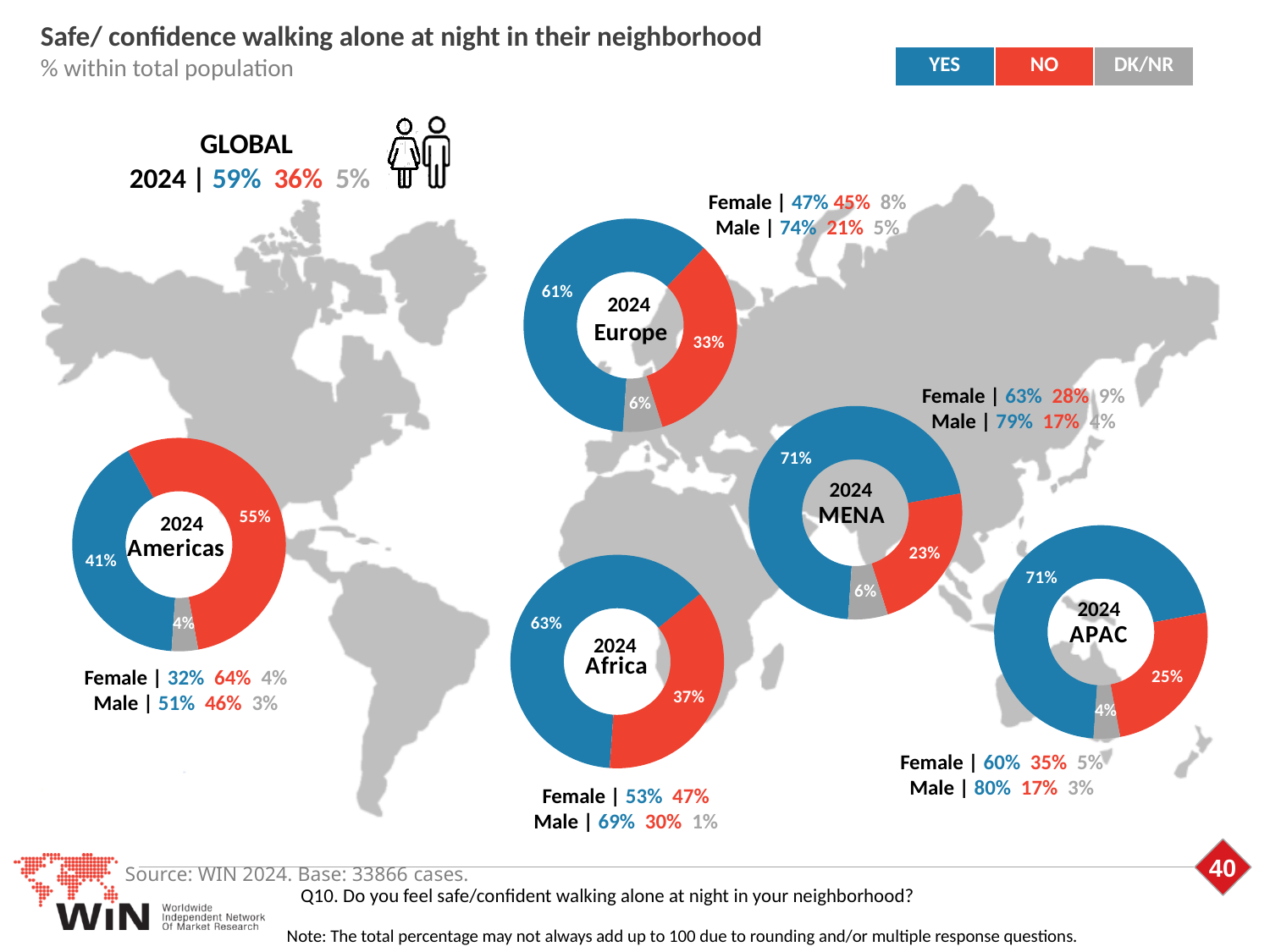
In the 2024 Africa donut chart, what percentage answered YES? 63% What is the difference between the YES percentage in the Europe chart and the YES percentage in the Americas chart? 20% What type of chart is used to show the 2024 results for each region? Donut (pie) chart How many response categories does the legend at the top of the slide list? 3 In the 2024 APAC donut chart, what percentage answered NO? 25% In the 2024 Americas donut chart, what percentage answered NO? 55% In the 2024 Europe donut chart, what percentage answered YES? 61% Across the five regional donut charts, which region has the highest NO percentage? Americas In the 2024 MENA donut chart, what percentage is DK/NR? 6% Which is larger: the NO percentage in the Africa chart or the NO percentage in the Europe chart? Africa How many regional donut charts are shown on the slide? 5 Across the five regional donut charts, which region has the lowest YES percentage? Americas